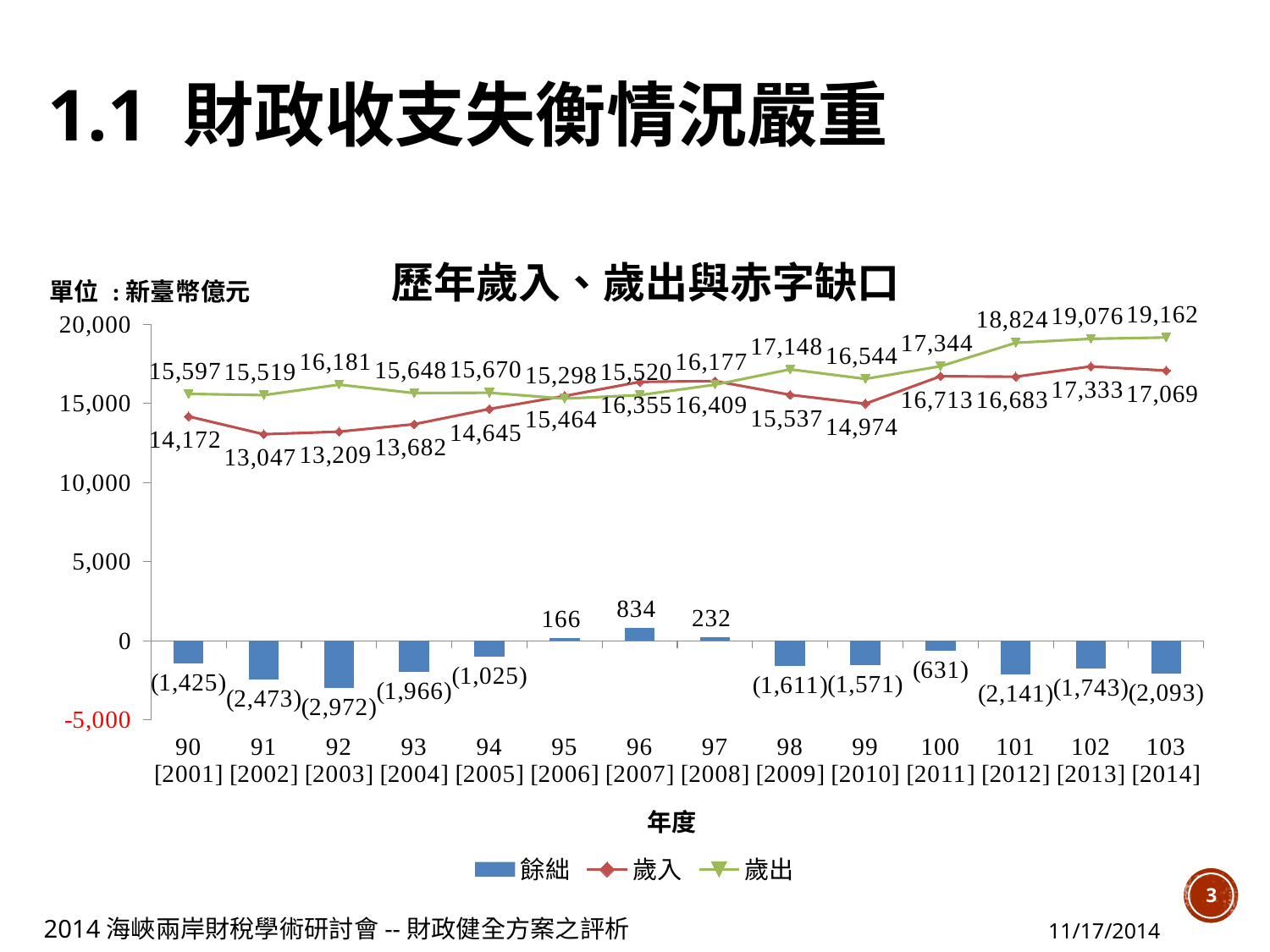
Does 歲出 rise or fall from 101 [2012] to 103 [2014]? Rise What is the value of 餘絀 for 96 [2007]? 834 What is the difference between 歲出 and 歲入 in 101 [2012]? 2,141 In 96 [2007], which is larger, 歲入 or 歲出? 歲入 What is the value of 歲入 for 103 [2014]? 17,069 What is the value of 歲出 for 90 [2001]? 15,597 In which year is the 餘絀 bar the most negative? 92 [2003] How many series does the legend list? 3 In which year is 歲出 the highest? 103 [2014] In which year is 歲入 the lowest? 91 [2002] What kind of chart is this? Combined bar and line chart How many years are shown on the x axis? 14